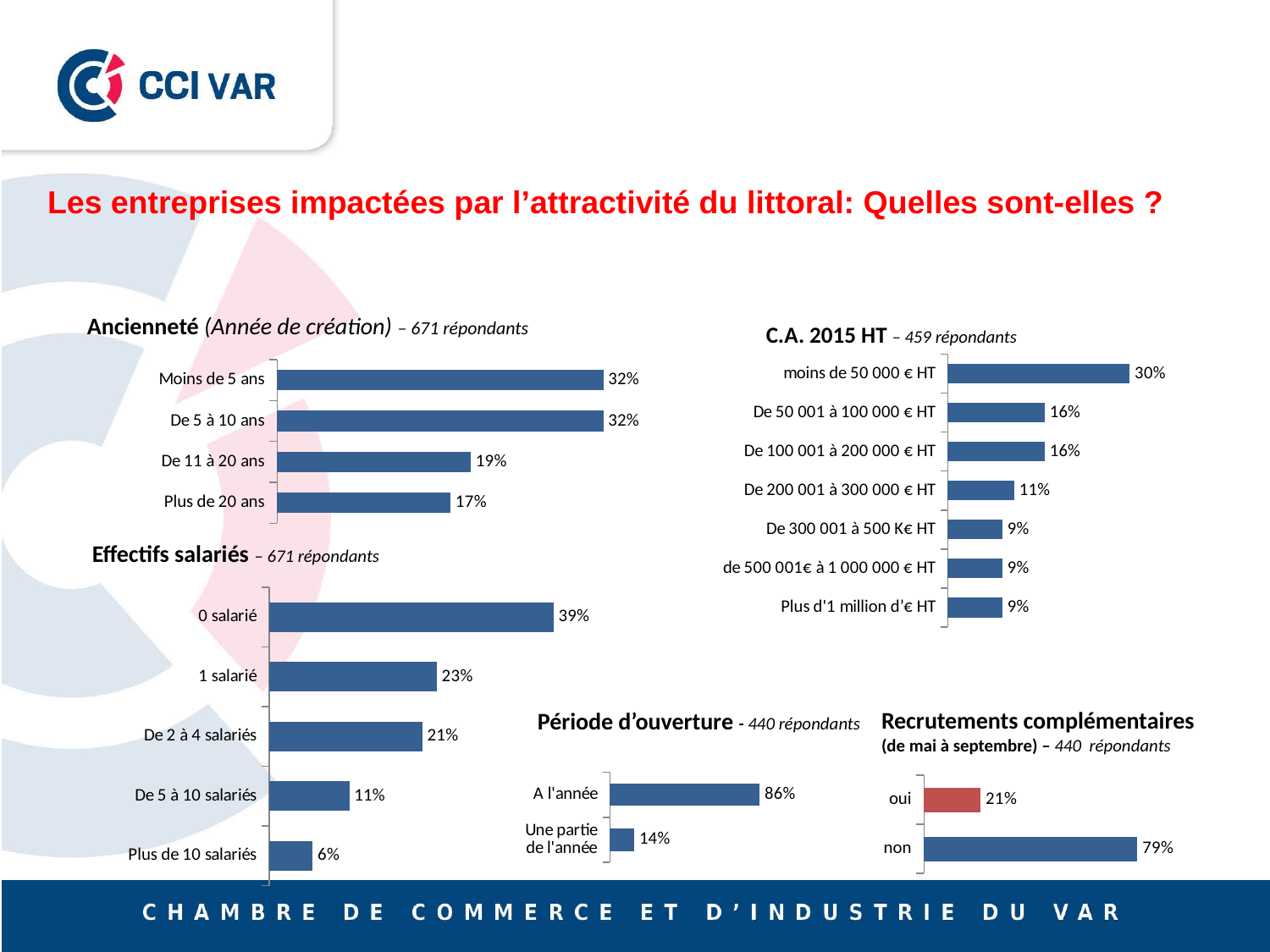
In the 'Ancienneté' chart, what is the value for 'De 11 à 20 ans'? 19% In the 'Recrutements complémentaires' chart, what is the difference between 'non' and 'oui'? 58% In the 'Ancienneté' chart, which category has the lowest value? Plus de 20 ans In the 'Période d'ouverture' chart, what is the value for 'A l'année'? 86% In the 'Effectifs salariés' chart, what is the difference between '1 salarié' and 'De 2 à 4 salariés'? 2% In the 'Recrutements complémentaires' chart, which is larger, 'oui' or 'non'? non In the 'Effectifs salariés' chart, what is the value for '0 salarié'? 39% In the 'Effectifs salariés' chart, how many categories are shown? 5 In the 'C.A. 2015 HT' chart, how many categories are shown? 7 In the 'C.A. 2015 HT' chart, which category has the highest value? moins de 50 000 € HT In the 'C.A. 2015 HT' chart, what is the value for 'De 200 001 à 300 000 € HT'? 11% What type of chart is the 'Ancienneté' chart? Bar chart